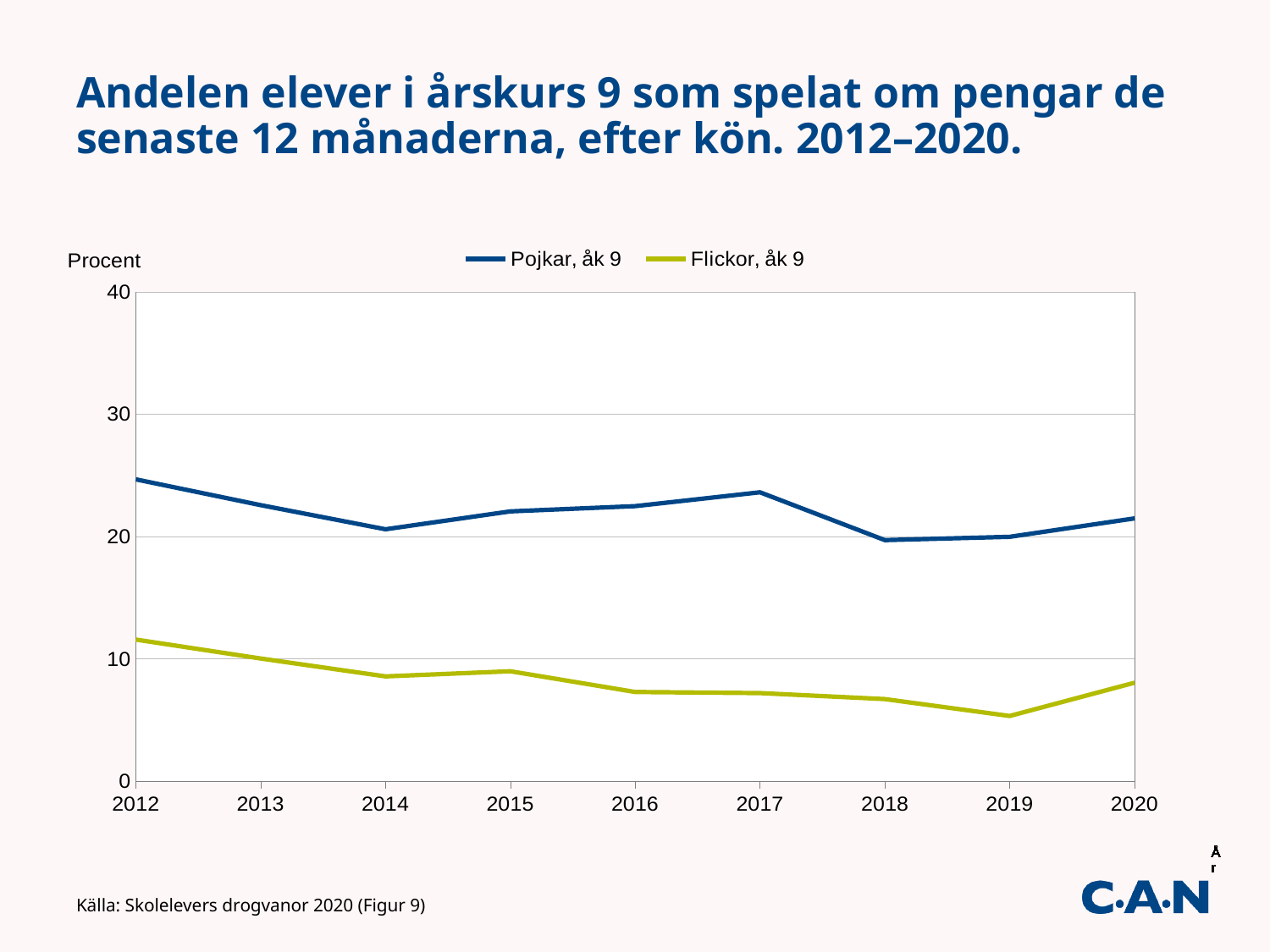
In which year is the value for Flickor, åk 9 lowest? 2019 Is the value for Pojkar, åk 9 in 2017 greater or less than 30? less In which year is the value for Pojkar, åk 9 highest? 2012 In which year is the value for Flickor, åk 9 highest? 2012 What label is shown on the vertical axis of the chart? Procent Is the value for Flickor, åk 9 in 2019 greater or less than 10? less Is the value for Pojkar, åk 9 in 2012 greater or less than 20? greater What kind of chart is shown on the slide? line chart How many series does the legend list? 2 Does the value for Flickor, åk 9 rise or fall from 2012 to 2019? fall Which series has the higher value in 2016, Pojkar, åk 9 or Flickor, åk 9? Pojkar, åk 9 How many years are plotted along the x axis? 9